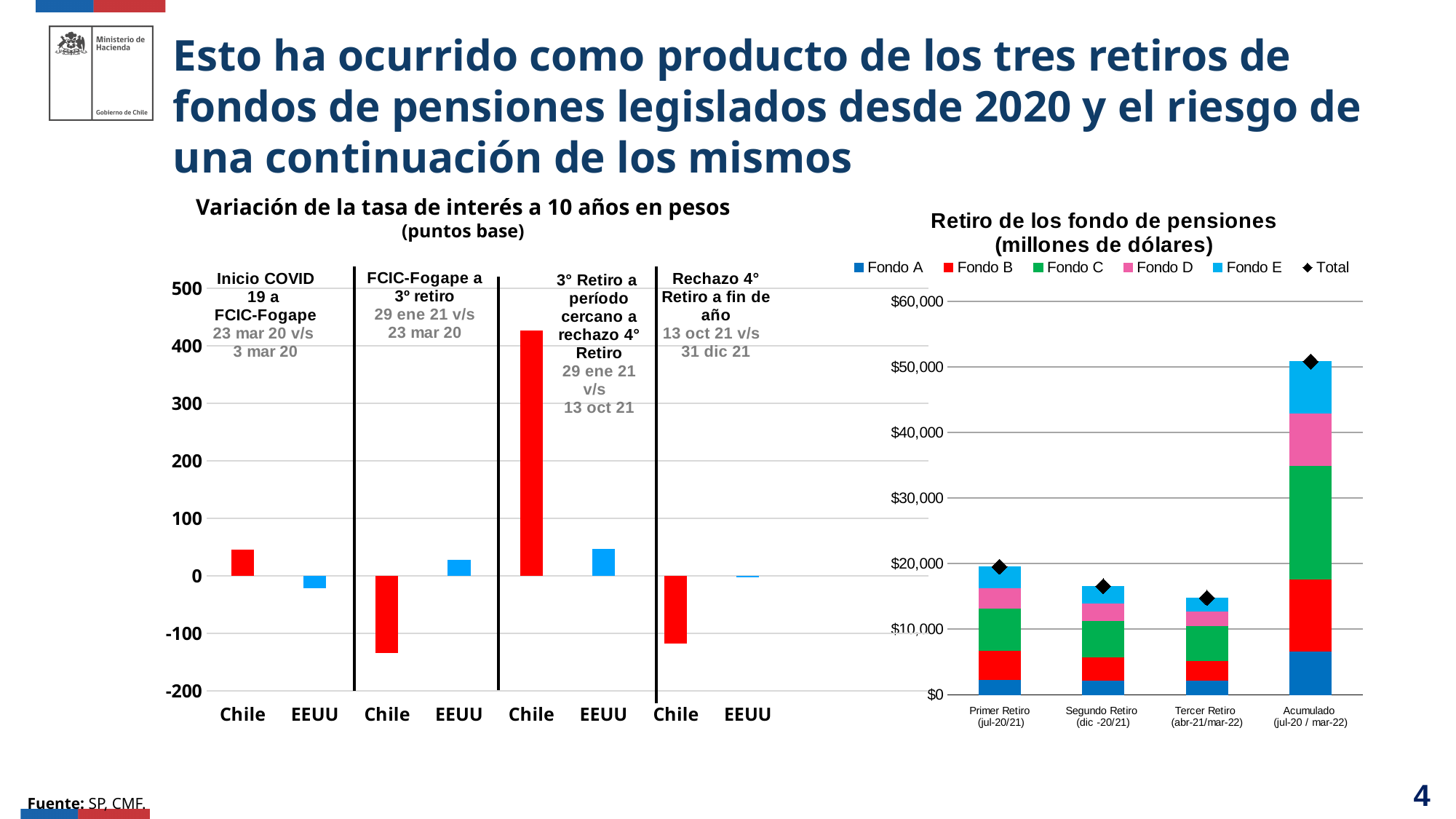
In the 'Retiro de los fondo de pensiones' chart, which category has the highest total? Acumulado (jul-20 / mar-22) In the 'Variación de la tasa de interés' chart, is the Chile bar in the 'FCIC-Fogape a 3º retiro' period greater or less than -100? less In the 'Variación de la tasa de interés' chart, is the Chile bar in the '3° Retiro a período cercano a rechazo 4° Retiro' period greater or less than 400? greater In the 'Variación de la tasa de interés' chart, what colour are the Chile bars? red In the 'Retiro de los fondo de pensiones' chart, do the totals rise or fall from Primer Retiro to Tercer Retiro? fall What kind of chart is the 'Retiro de los fondo de pensiones' chart on the right? stacked bar chart In the 'Retiro de los fondo de pensiones' chart, which is larger, the total for Primer Retiro or the total for Tercer Retiro? Primer Retiro In the 'Retiro de los fondo de pensiones' chart, is the total for Acumulado greater or less than $50,000? greater In the 'Retiro de los fondo de pensiones' chart, how many entries does the legend list? 6 What kind of chart is the 'Variación de la tasa de interés a 10 años en pesos' chart on the left? bar chart In the 'Retiro de los fondo de pensiones' chart, how many categories are shown on the x axis? 4